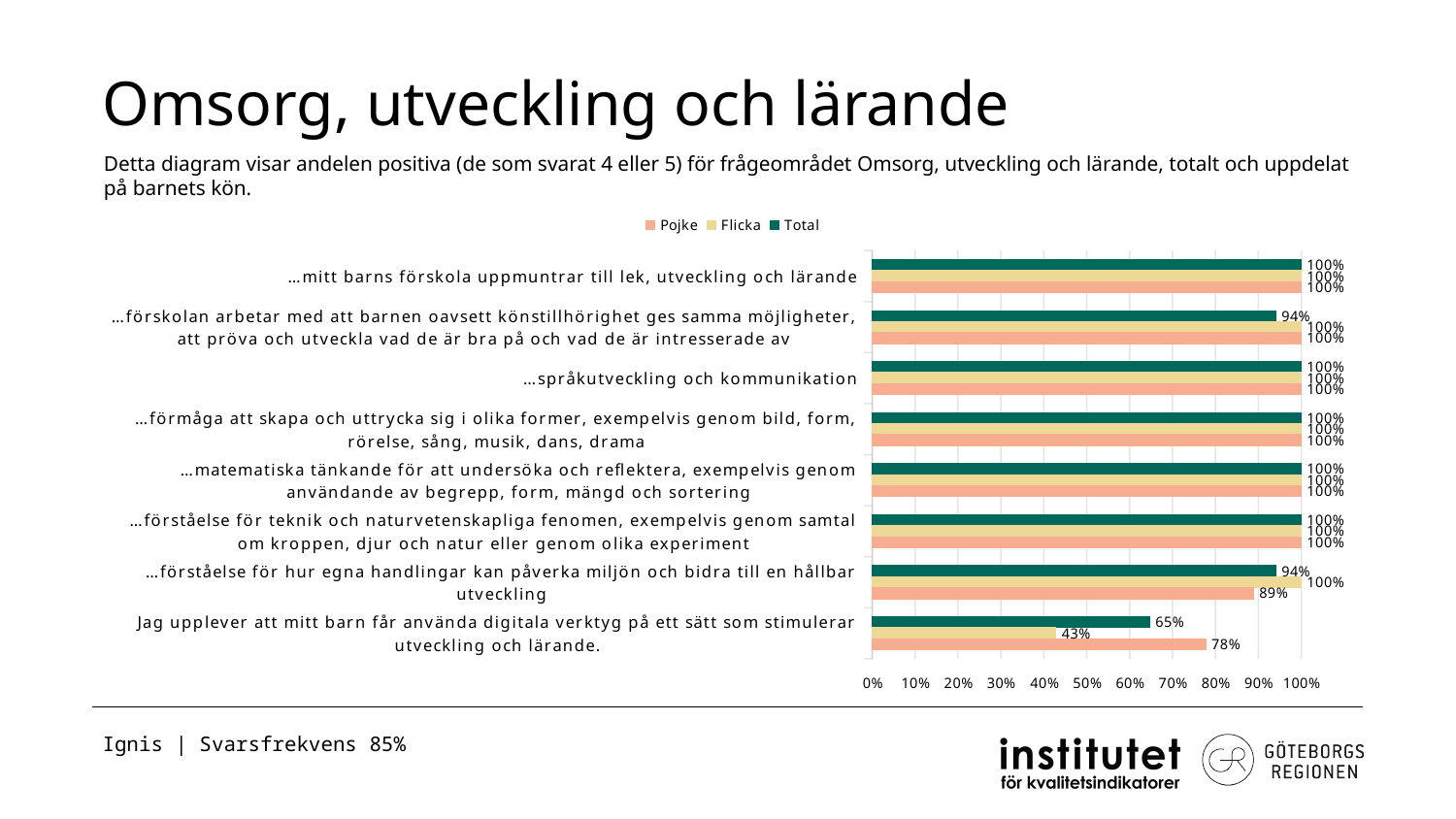
What is the difference between the Pojke and Flicka values for "Jag upplever att mitt barn får använda digitala verktyg på ett sätt som stimulerar utveckling och lärande."? 35 percentage points What is the Total value for "…förskolan arbetar med att barnen oavsett könstillhörighet ges samma möjligheter, att pröva och utveckla vad de är bra på och vad de är intresserade av"? 94% What kind of chart is shown on the slide? bar chart How many series does the legend list? 3 Which category has the lowest Total value? Jag upplever att mitt barn får använda digitala verktyg på ett sätt som stimulerar utveckling och lärande. How many categories (statements) are plotted on the chart? 8 Which series is shown in dark green in the legend? Total For "…förståelse för hur egna handlingar kan påverka miljön och bidra till en hållbar utveckling", which is larger, the Flicka value or the Pojke value? Flicka What is the Pojke value for "…förståelse för hur egna handlingar kan påverka miljön och bidra till en hållbar utveckling"? 89% What is the Total value for "Jag upplever att mitt barn får använda digitala verktyg på ett sätt som stimulerar utveckling och lärande."? 65% What is the Flicka value for "Jag upplever att mitt barn får använda digitala verktyg på ett sätt som stimulerar utveckling och lärande."? 43% What is the Pojke value for "Jag upplever att mitt barn får använda digitala verktyg på ett sätt som stimulerar utveckling och lärande."? 78%